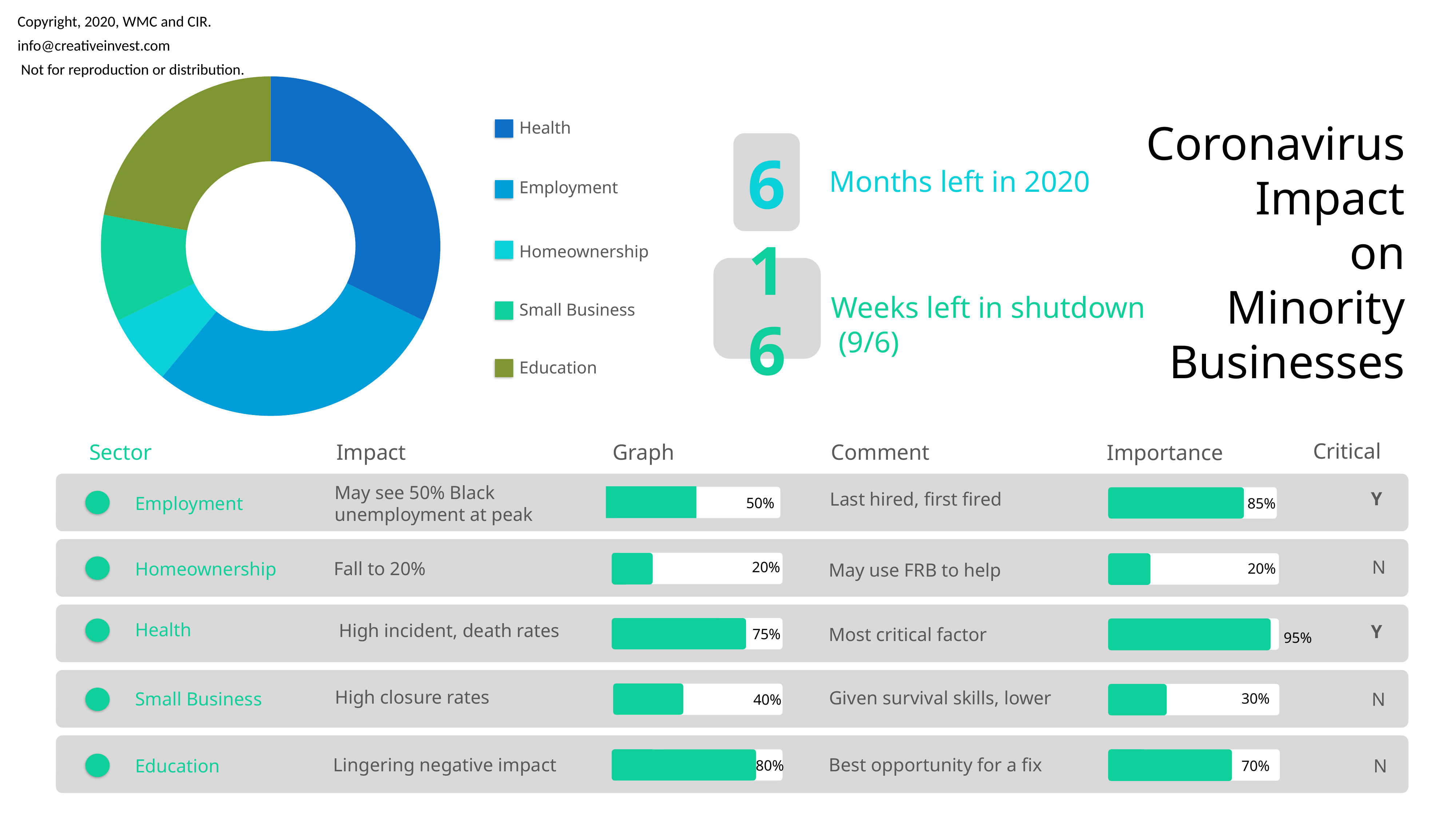
In the table's Graph column, what is the difference between the Education value and the Homeownership value? 60% In the table's Graph column, what value is shown for Health? 75% In the table's Importance column, what value is shown for Health? 95% How many categories does the donut chart's legend list? 5 In the table's Graph column, what value is shown for Education? 80% Which category has the smallest slice in the donut chart? Homeownership In the donut chart, which slice is larger, Education or Small Business? Education In the table's Importance column, what value is shown for Small Business? 30% Which legend entry of the donut chart is shown in olive green? Education In the donut chart, which slice is larger, Homeownership or Health? Health What kind of chart is shown at the top left of the slide? Donut chart In the table's Importance column, which sector has the lowest value? Homeownership